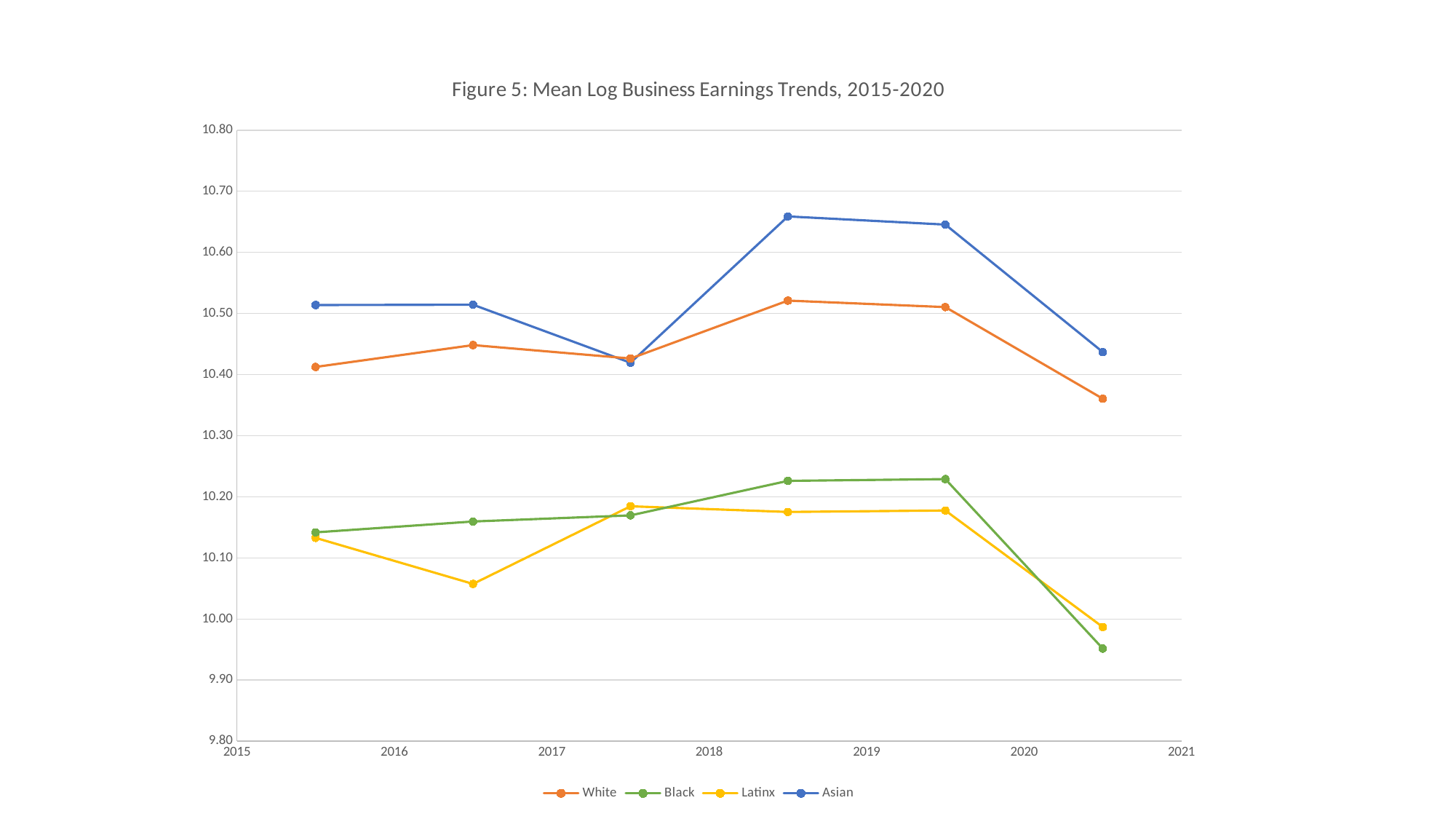
At the second data point (between the 2016 and 2017 ticks), which series is larger, Black or Latinx? Black Is the value of the last Black data point (between the 2020 and 2021 ticks) greater or less than 10.00? less Which series reaches the highest value anywhere on the chart? Asian How many series does the legend list? 4 How many data points are plotted for the Asian series? 6 Does the Black series rise or fall between its fifth and sixth data points? fall Is the value of the last White data point (between the 2020 and 2021 ticks) greater or less than 10.40? less At the last data point (between the 2020 and 2021 ticks), which series is larger, Black or Latinx? Latinx Is the value of the fourth Asian data point (between the 2018 and 2019 ticks) greater or less than 10.60? greater What kind of chart is shown on the slide? Line chart What is the title of the chart? Figure 5: Mean Log Business Earnings Trends, 2015-2020 Which series reaches the lowest value anywhere on the chart? Black